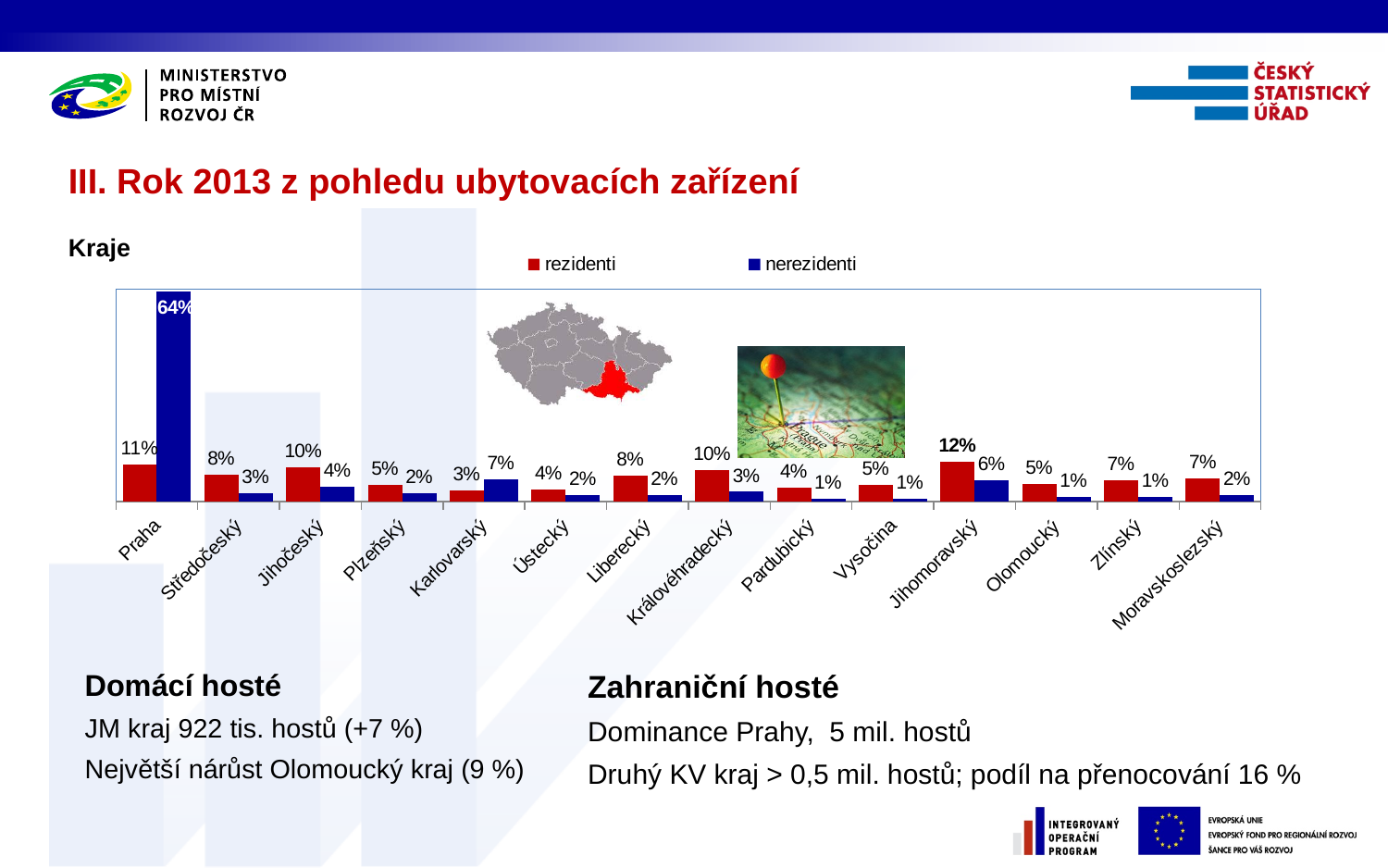
How many regions are shown on the x axis of the chart? 14 What is the rezidenti value for Jihomoravský? 12% Which region has the lowest rezidenti value? Karlovarský What is the difference between the nerezidenti and rezidenti values for Praha? 53% Which region has the highest rezidenti value? Jihomoravský Which is larger for Karlovarský, the rezidenti value or the nerezidenti value? nerezidenti What is the nerezidenti value for Praha? 64% Which region has the highest nerezidenti value? Praha What kind of chart is shown on the slide? bar chart What is the nerezidenti value for Karlovarský? 7% How many series does the legend list? 2 What is the rezidenti value for Královéhradecký? 10%